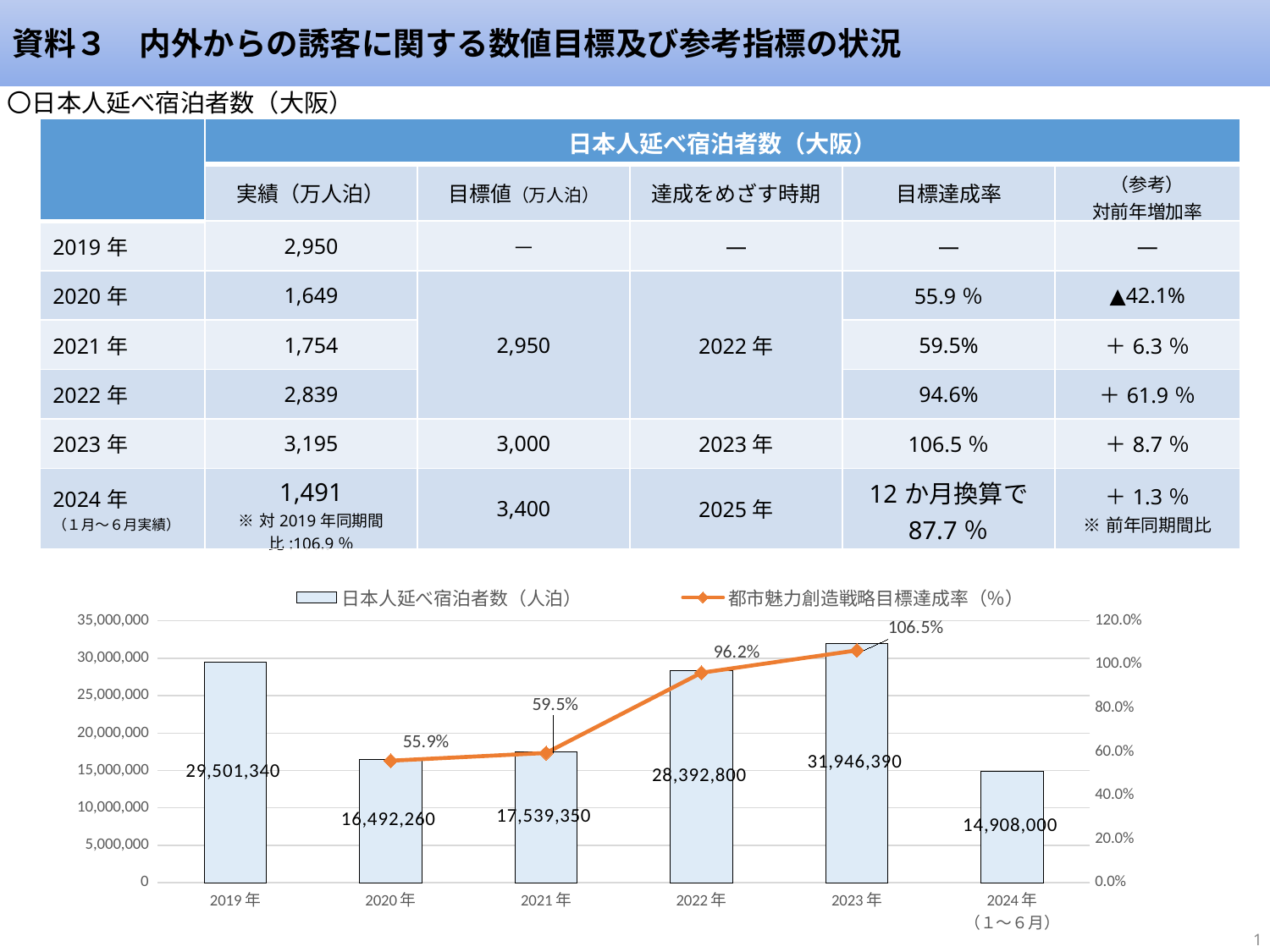
In the chart, what is the difference in 日本人延べ宿泊者数（人泊） between 2023年 and 2022年? 3,553,590 How many series does the chart legend list? 2 How many categories are shown on the x axis of the chart? 6 In the chart, which category has the lowest 日本人延べ宿泊者数（人泊）? 2024年（1～6月） In the chart, is the 日本人延べ宿泊者数（人泊） for 2022年 greater or less than 25,000,000? greater In the chart, which year has the highest 日本人延べ宿泊者数（人泊）? 2023年 Does the 都市魅力創造戦略目標達成率（%） line rise or fall from 2020年 to 2023年? rise In the chart, what is the 都市魅力創造戦略目標達成率（%） for 2022年? 96.2% In the chart, what is the value of 日本人延べ宿泊者数（人泊） for 2019年? 29,501,340 In the chart, what is the value of 日本人延べ宿泊者数（人泊） for 2023年? 31,946,390 In the chart, what is the 都市魅力創造戦略目標達成率（%） for 2020年? 55.9% In the chart, which is larger, the 日本人延べ宿泊者数（人泊） for 2020年 or for 2021年? 2021年